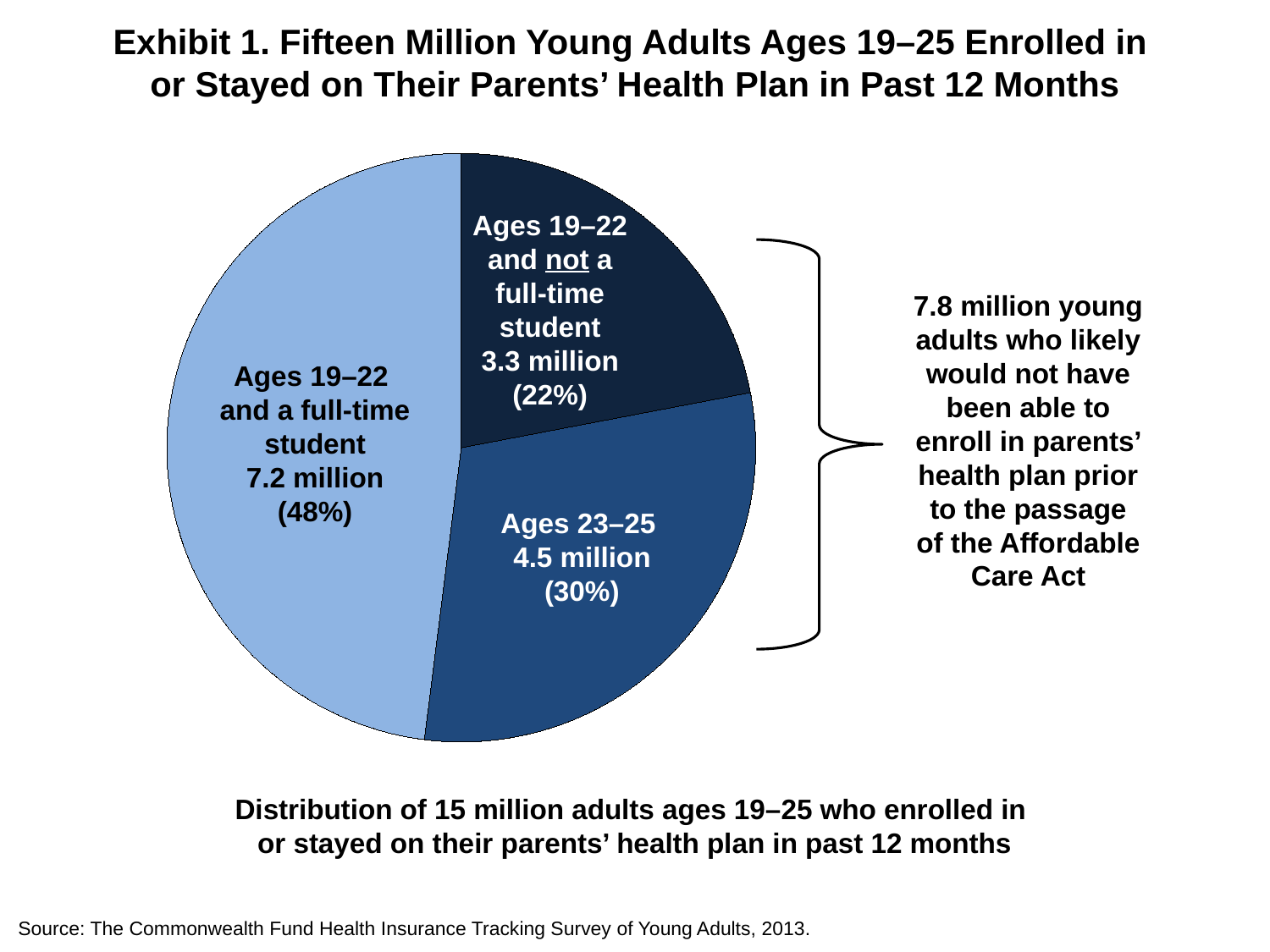
What kind of chart is shown on the slide? Pie chart According to the bracket annotation, how many million young adults likely would not have been able to enroll in parents' health plan prior to the Affordable Care Act? 7.8 million What is the total number of adults ages 19–25 represented in the pie chart, according to the caption below it? 15 million How many slices does the pie chart have? 3 Which is larger: the 'Ages 23–25' slice or the 'Ages 19–22 and not a full-time student' slice? Ages 23–25 What percentage of the pie is the 'Ages 19–22 and not a full-time student' slice? 22% What is the difference in millions between the 'Ages 19–22 and a full-time student' slice and the 'Ages 23–25' slice? 2.7 million How many million young adults are in the 'Ages 19–22 and a full-time student' slice? 7.2 million Which slice of the pie is the smallest? Ages 19–22 and not a full-time student What percentage of the pie is the 'Ages 23–25' slice? 30% How many million young adults are in the 'Ages 19–22 and not a full-time student' slice? 3.3 million Which slice of the pie is the largest? Ages 19–22 and a full-time student